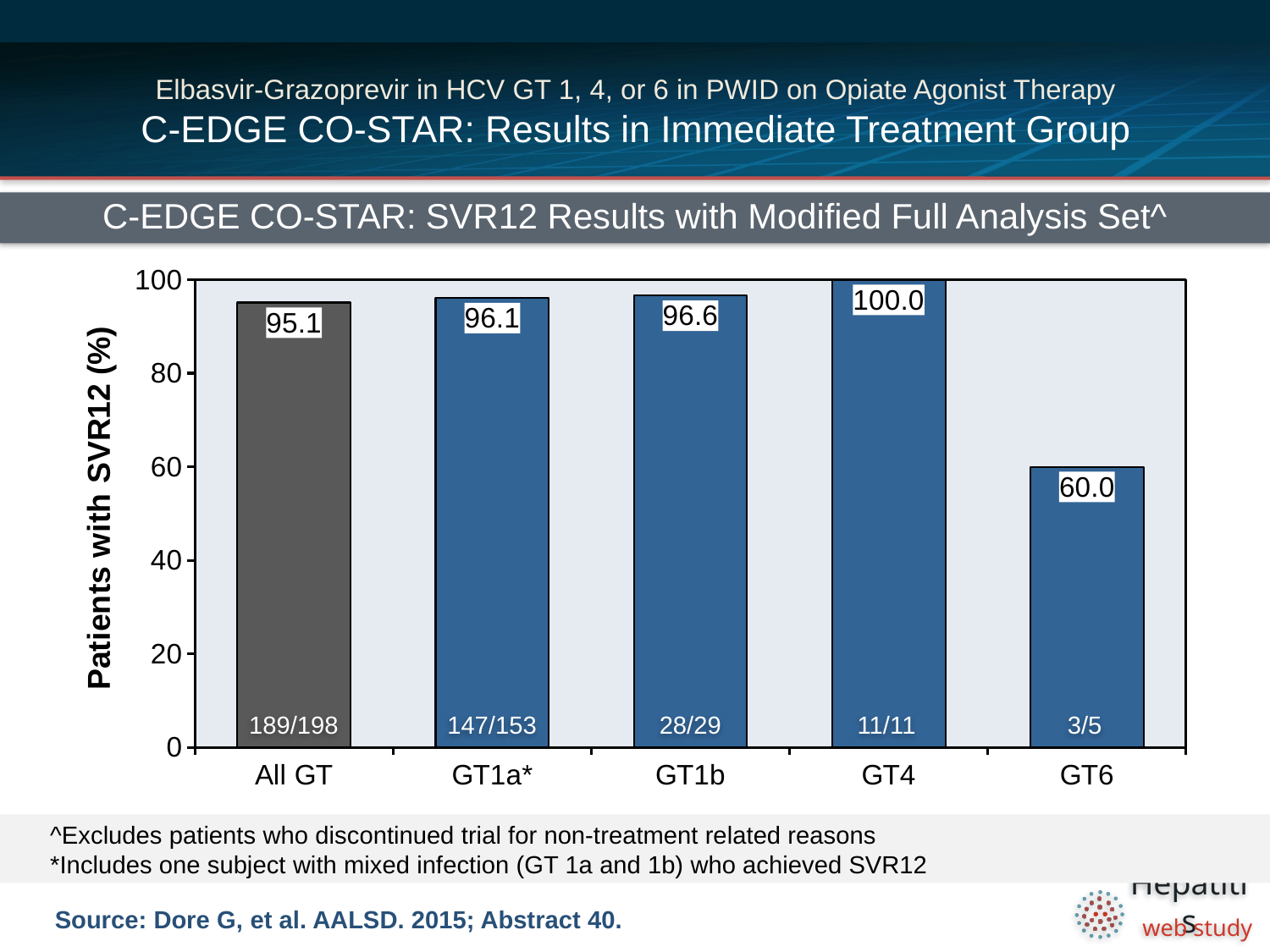
What is the SVR12 rate for GT4? 100.0 What is the label of the y axis? Patients with SVR12 (%) What is the difference between the SVR12 rates for GT1b and GT1a*? 0.5 Which has a higher SVR12 rate, GT1a* or GT6? GT1a* What is the difference between the SVR12 rates for GT4 and GT6? 40.0 What is the SVR12 rate for All GT? 95.1 What kind of chart is shown on the slide? Bar chart What is the SVR12 rate for GT6? 60.0 Which category has the highest SVR12 rate? GT4 Which category has the lowest SVR12 rate? GT6 What fraction of patients is shown inside the GT1b bar? 28/29 How many categories are shown on the x axis? 5